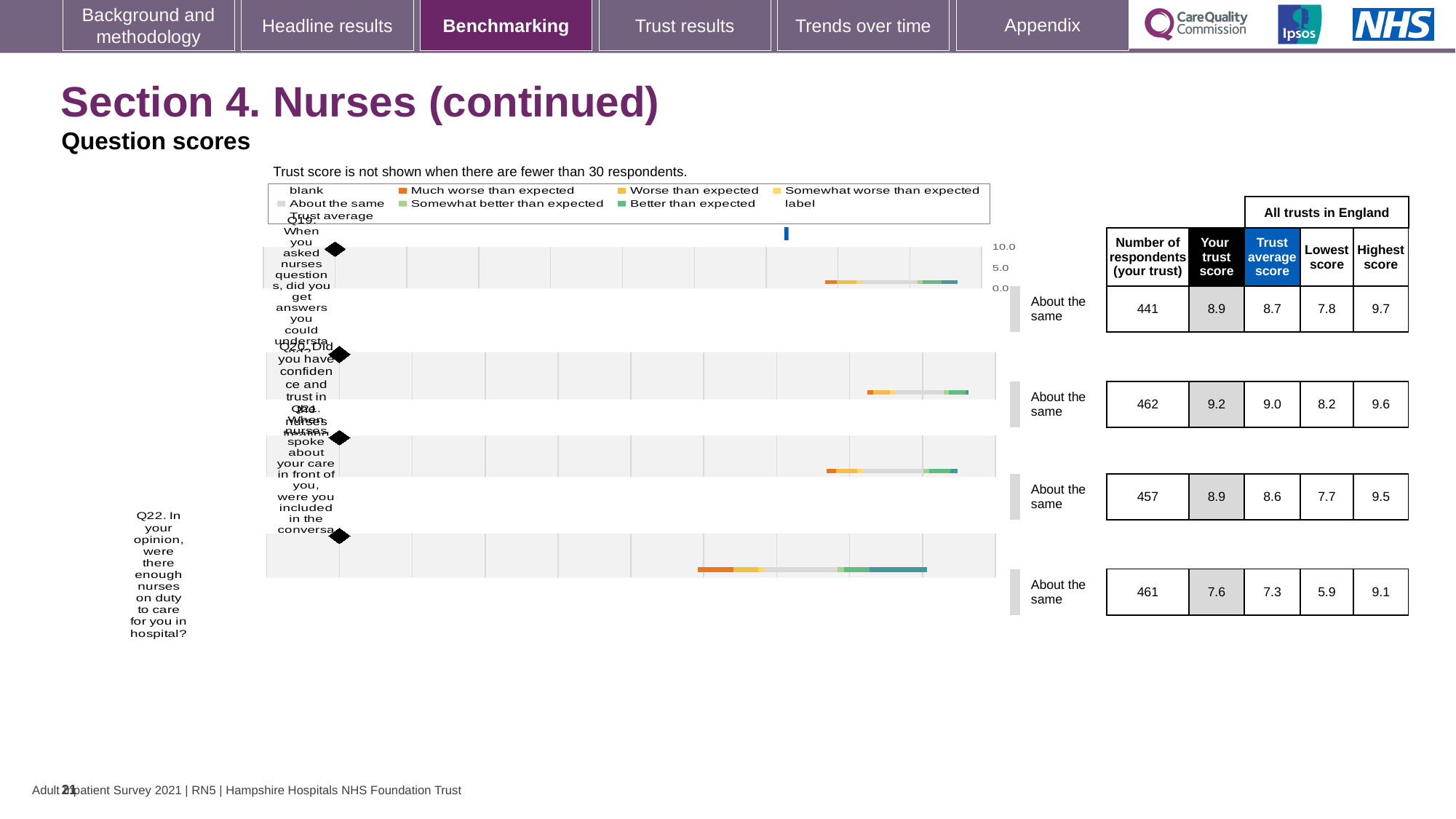
What is the maximum value shown on the chart's score axis? 10.0 What is the lowest score across all trusts in England for Q22? 5.9 How many questions are plotted in the chart? 4 What is the highest score across all trusts in England for Q21? 9.5 What is the trust average score for Q20 (confidence and trust in nurses)? 9.0 Is the trust score for Q19 larger or smaller than the trust average score for Q19? larger How many respondents answered Q19 for this trust? 441 What is the benchmark category shown for Q21? About the same What is the trust score for Q22 (enough nurses on duty) shown in the 'Your trust score' column? 7.6 What is the difference between the trust score and the trust average score for Q22? 0.3 Which of the four questions has the lowest 'Your trust score'? Q22 Which of the four questions has the highest 'Your trust score'? Q20